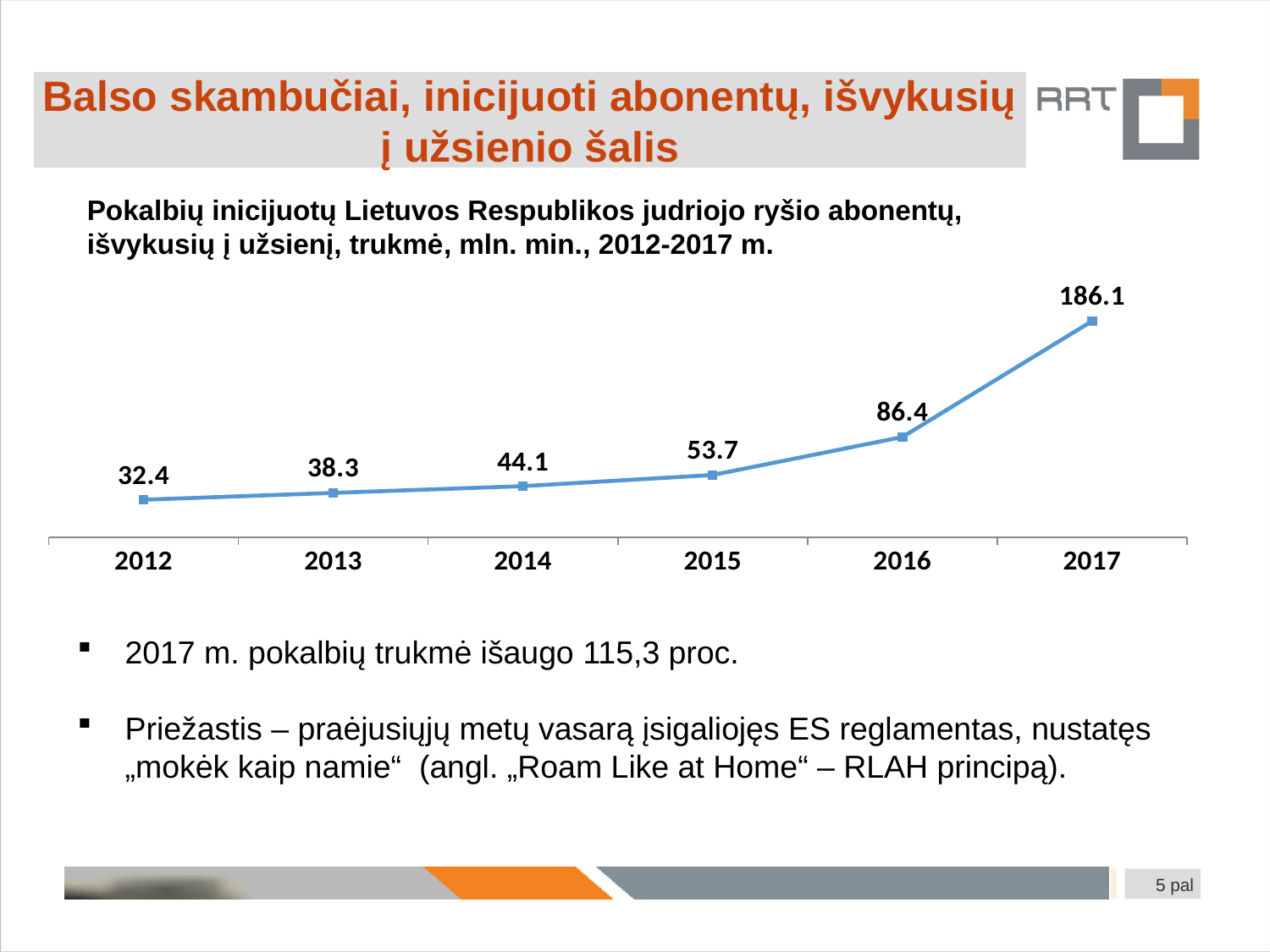
In what unit are the values on the chart expressed, according to the chart heading? mln. min. What is the value for 2015? 53.7 What kind of chart is shown on the slide? line chart Which year has the highest value? 2017 What is the value for 2012? 32.4 How many years are plotted on the chart? 6 Which is larger, the value for 2016 or the value for 2015? 2016 Do the values rise or fall from 2012 to 2017? rise What is the difference between the values for 2014 and 2013? 5.8 Which year has the lowest value? 2012 What is the value for 2017? 186.1 What is the difference between the values for 2017 and 2016? 99.7